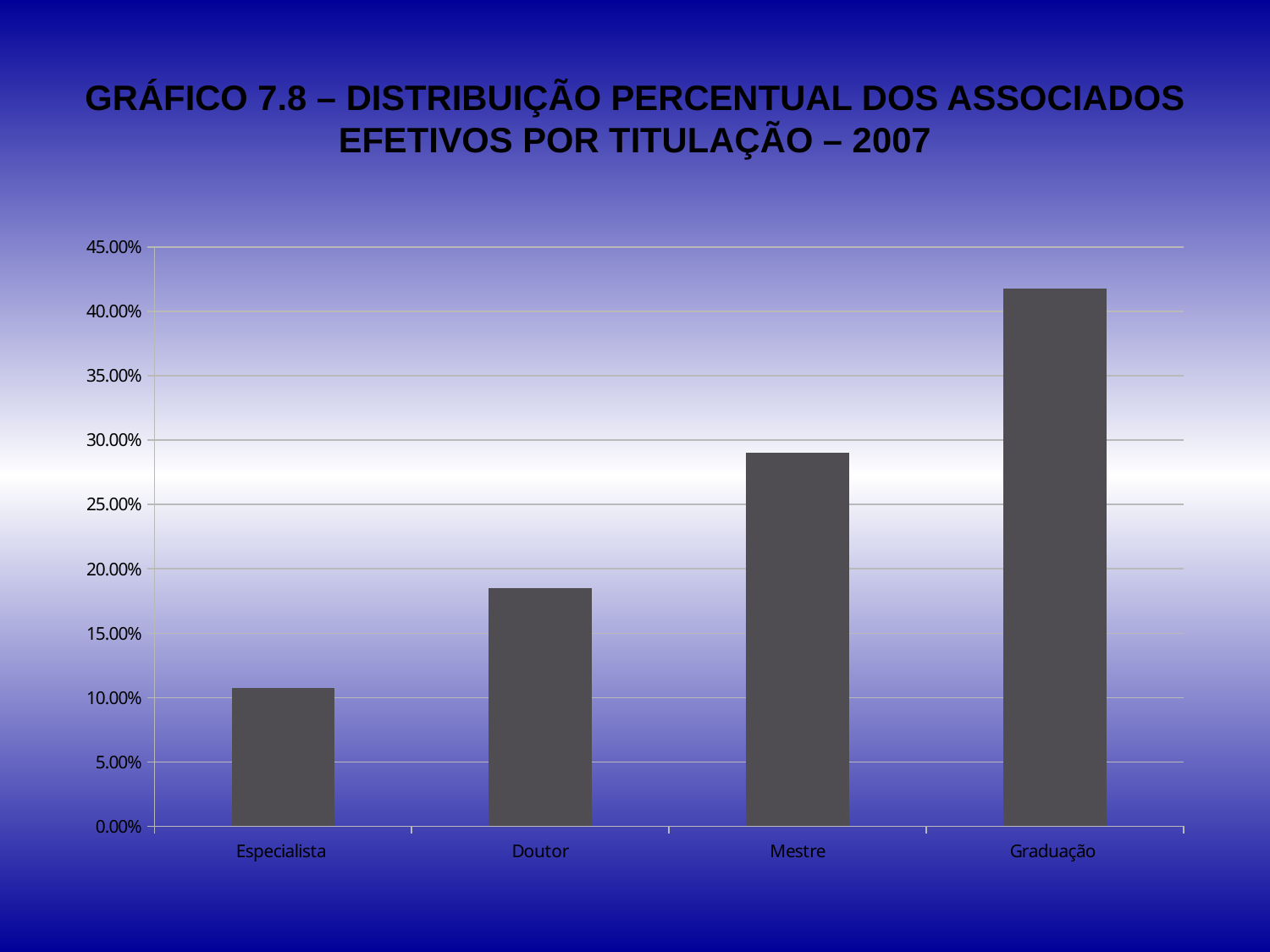
Is the value for Doutor greater or less than 15.00%? greater Do the bar values rise or fall from left to right across the x axis? rise Is the value for Especialista greater or less than 15.00%? less What year is referenced in the chart title? 2007 Is the value for Graduação greater or less than 40.00%? greater How many categories are shown on the x axis of the chart? 4 Which is larger, the value for Especialista or the value for Graduação? Graduação Which is larger, the value for Mestre or the value for Doutor? Mestre What kind of chart is shown on the slide? bar chart Which category has the lowest value in the chart? Especialista Which category has the highest value in the chart? Graduação